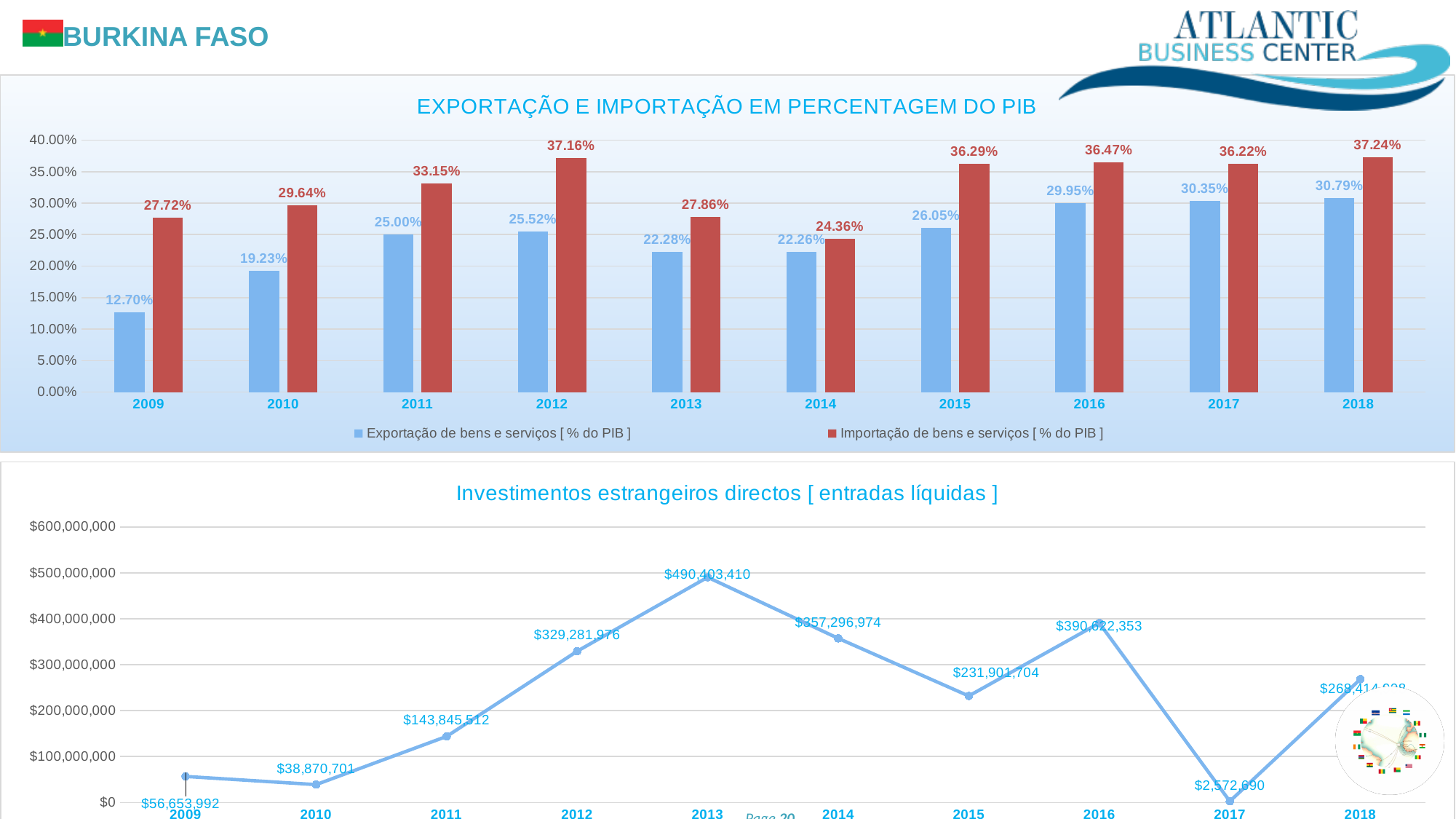
In the chart 'EXPORTAÇÃO E IMPORTAÇÃO EM PERCENTAGEM DO PIB', what is the value of Importação de bens e serviços for 2012? 37.16% In the chart 'EXPORTAÇÃO E IMPORTAÇÃO EM PERCENTAGEM DO PIB', how many series does the legend list? 2 In the chart 'Investimentos estrangeiros directos [ entradas líquidas ]', is the value for 2015 larger or smaller than the value for 2014? Smaller In the chart 'Investimentos estrangeiros directos [ entradas líquidas ]', which year has the lowest value? 2017 In the chart 'EXPORTAÇÃO E IMPORTAÇÃO EM PERCENTAGEM DO PIB', what is the value of Exportação de bens e serviços for 2009? 12.70% In the chart 'EXPORTAÇÃO E IMPORTAÇÃO EM PERCENTAGEM DO PIB', which year has the lowest Exportação de bens e serviços value? 2009 In the chart 'EXPORTAÇÃO E IMPORTAÇÃO EM PERCENTAGEM DO PIB', what is the difference between Importação and Exportação in 2014? 2.10% In the chart 'Investimentos estrangeiros directos [ entradas líquidas ]', what is the value for 2013? $490,403,410 In the chart 'EXPORTAÇÃO E IMPORTAÇÃO EM PERCENTAGEM DO PIB', which year has the highest Importação de bens e serviços value? 2018 In the chart 'EXPORTAÇÃO E IMPORTAÇÃO EM PERCENTAGEM DO PIB', how many years are shown on the x axis? 10 What kind of chart is 'Investimentos estrangeiros directos [ entradas líquidas ]'? Line chart What kind of chart is 'EXPORTAÇÃO E IMPORTAÇÃO EM PERCENTAGEM DO PIB'? Bar chart